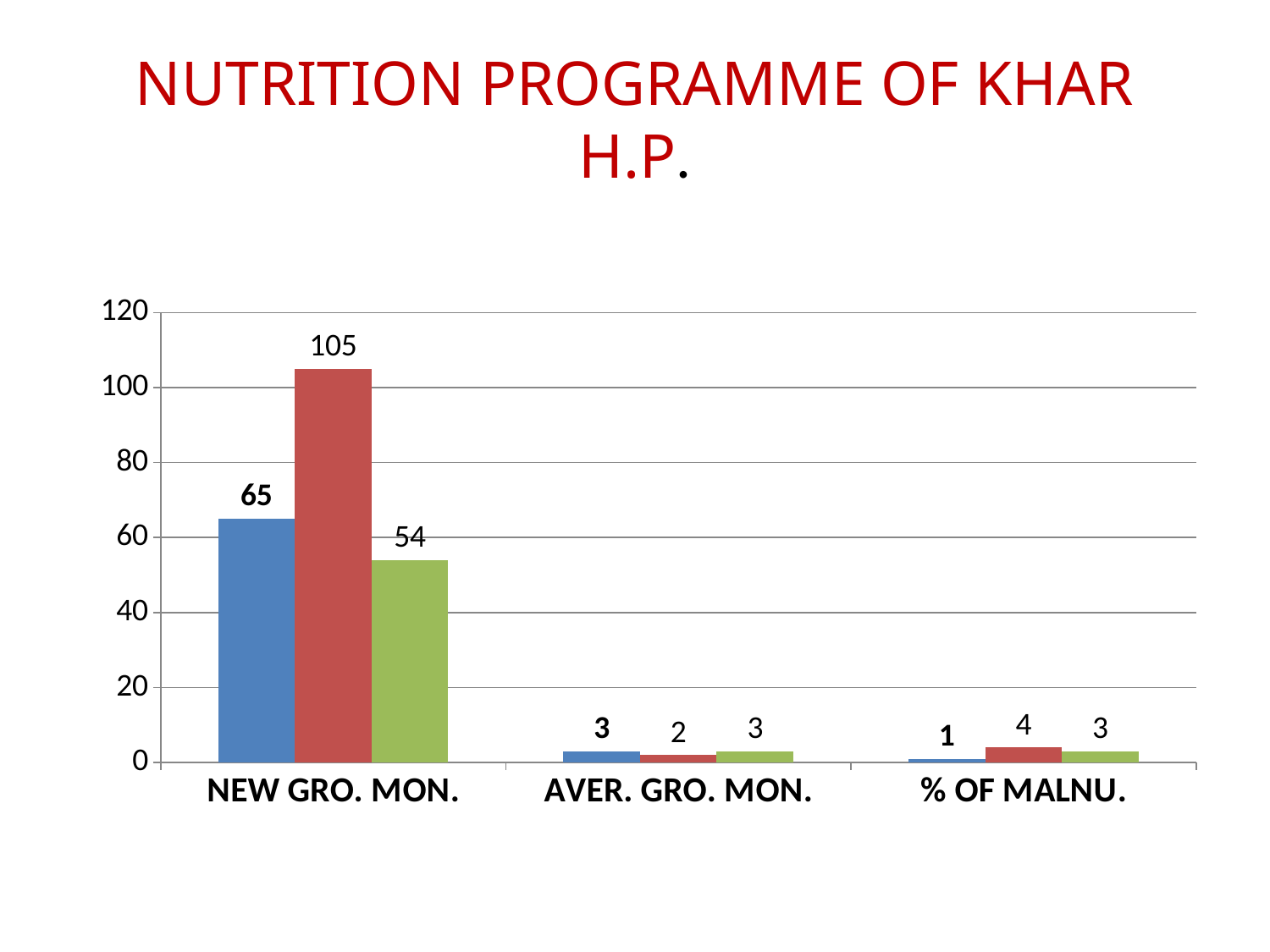
For % OF MALNU., which is larger, the red bar or the green bar? the red bar What is the value of the red bar for NEW GRO. MON.? 105 What is the value of the blue bar for % OF MALNU.? 1 What kind of chart is shown on the slide? bar chart What is the difference between the red bar and the blue bar for NEW GRO. MON.? 40 What is the difference between the red bar and the green bar for NEW GRO. MON.? 51 What is the value of the green bar for NEW GRO. MON.? 54 Is the value of the red bar for NEW GRO. MON. greater or less than 100? greater What is the value of the red bar for AVER. GRO. MON.? 2 Which category has the highest bar on the chart? NEW GRO. MON. How many categories are shown on the x axis? 3 What is the value of the blue bar for NEW GRO. MON.? 65